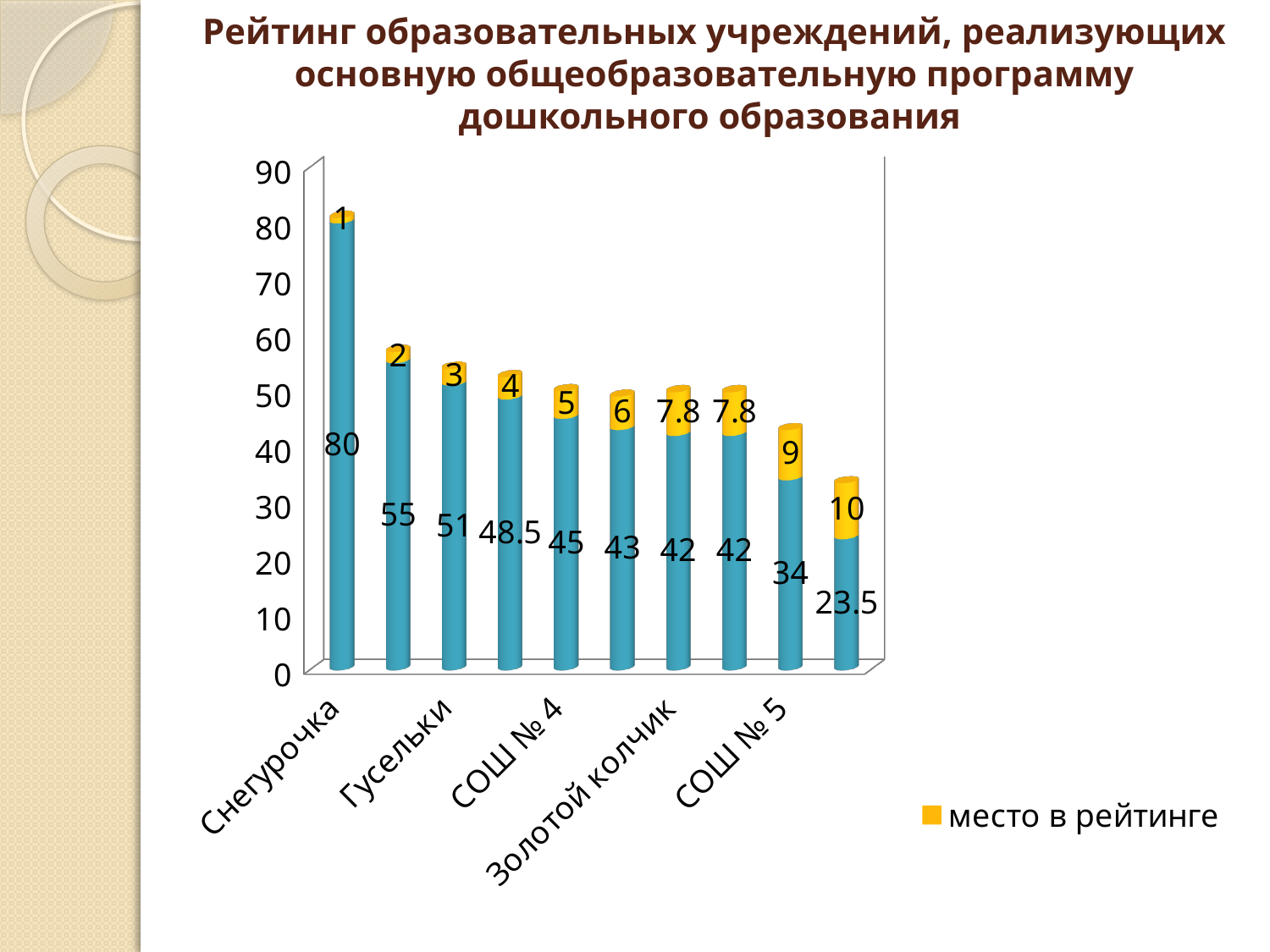
Which has a larger blue-bar value, СОШ № 4 or СОШ № 5? СОШ № 4 Which labeled institution has the highest blue-bar value? Снегурочка Do the blue-bar values rise or fall from left to right along the x axis? fall What is the blue-bar value for Снегурочка? 80 What is the blue-bar value for Золотой колчик? 42 What kind of chart is shown on the slide? bar chart What is the 'место в рейтинге' value shown for Золотой колчик? 7.8 What is the blue-bar value for СОШ № 4? 45 What is the blue-bar value for Гусельки? 51 How many bars are plotted in the chart? 10 What is the blue-bar value for СОШ № 5? 34 What is the difference between the blue-bar values for Снегурочка and Гусельки? 29